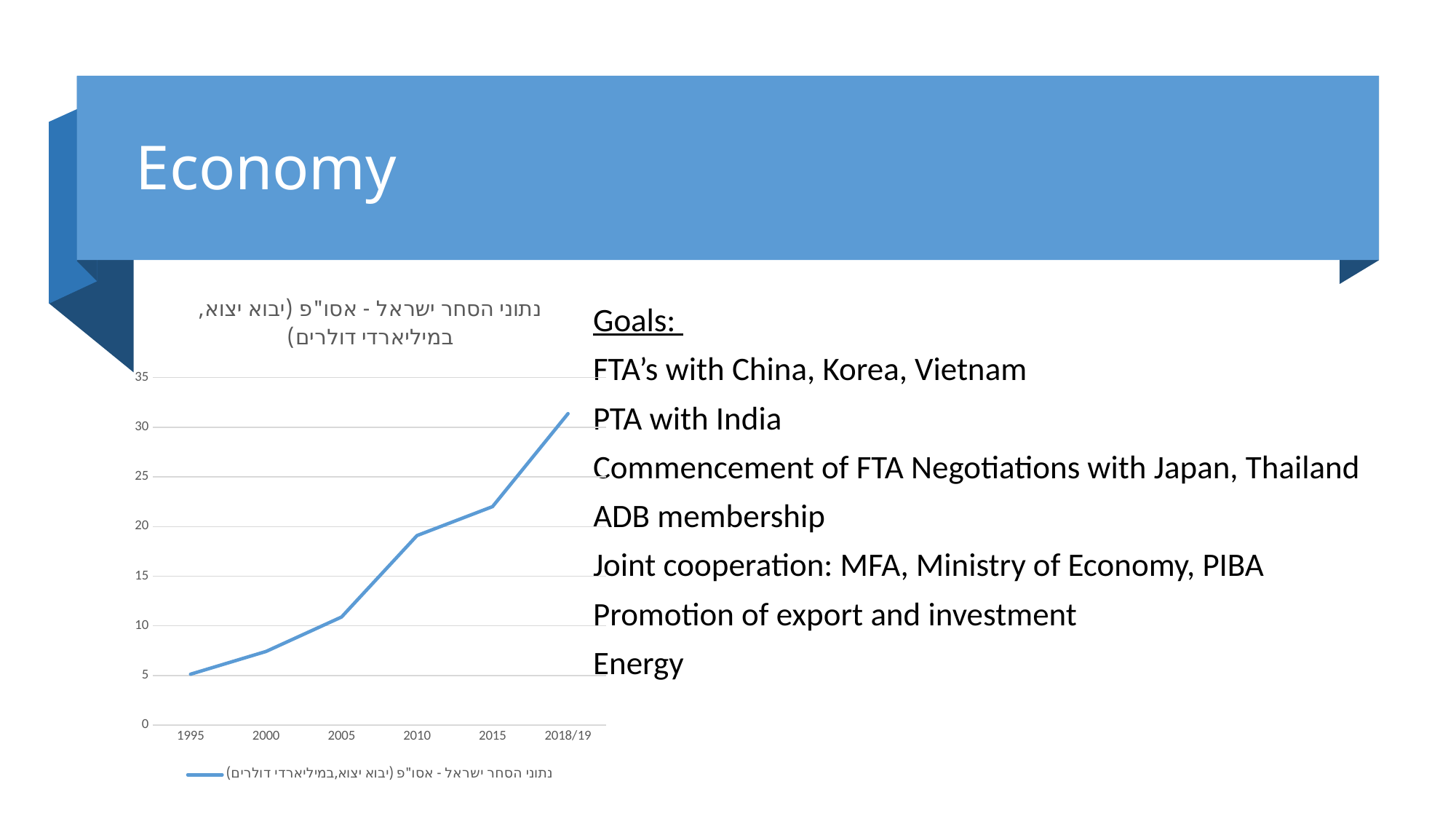
Which year has the lowest value in the chart? 1995 Is the value for 2018/19 greater or less than 30? greater Which is larger, the value for 2015 or the value for 2010? 2015 Do the values in the chart rise or fall from 1995 to 2018/19? rise Is the value for 2000 greater or less than 10? less What kind of chart is shown on the slide? line chart Is the value for 2005 greater or less than 15? less How many points are plotted along the x axis of the chart? 6 What is the last category label on the x axis of the chart? 2018/19 How many series does the chart's legend list? 1 Which year has the highest value in the chart? 2018/19